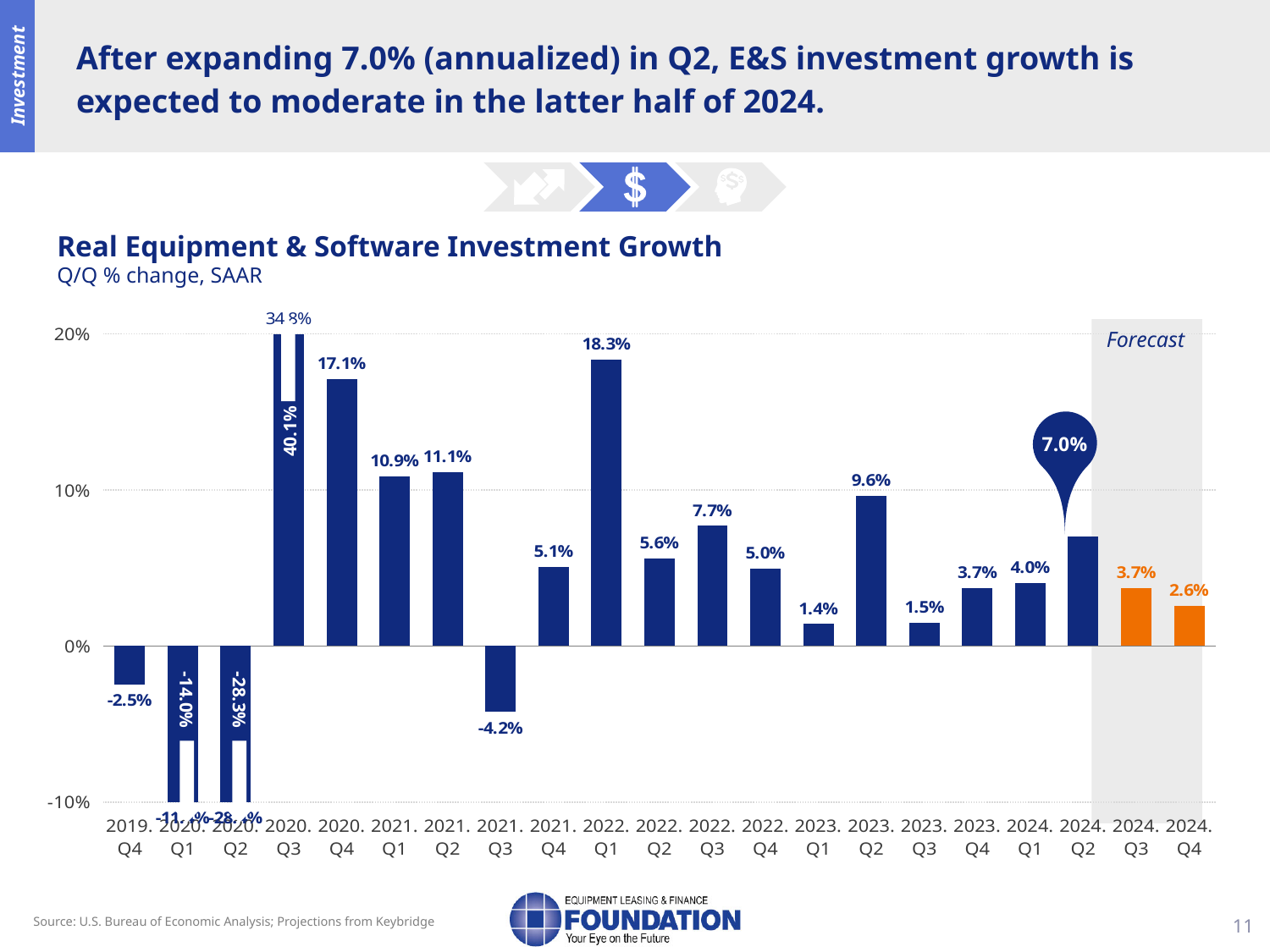
What is the value shown for 2021 Q3? -4.2% Which quarter has the highest investment growth value? 2020 Q3 What kind of chart is shown on the slide? Bar chart How many quarters are plotted on the chart? 21 Is the value for 2020 Q4 greater or less than 10%? greater Which quarter has the lowest investment growth value? 2020 Q2 What is the forecast value for 2024 Q4? 2.6% What is the investment growth value shown for 2024 Q2? 7.0% What is the Real Equipment & Software Investment Growth value for 2022 Q1? 18.3% Which is larger, the value for 2022 Q2 or 2022 Q3? 2022 Q3 What is the difference between the values for 2024 Q2 and 2024 Q3? 3.3 percentage points What is the difference between the values for 2023 Q2 and 2023 Q3? 8.1 percentage points